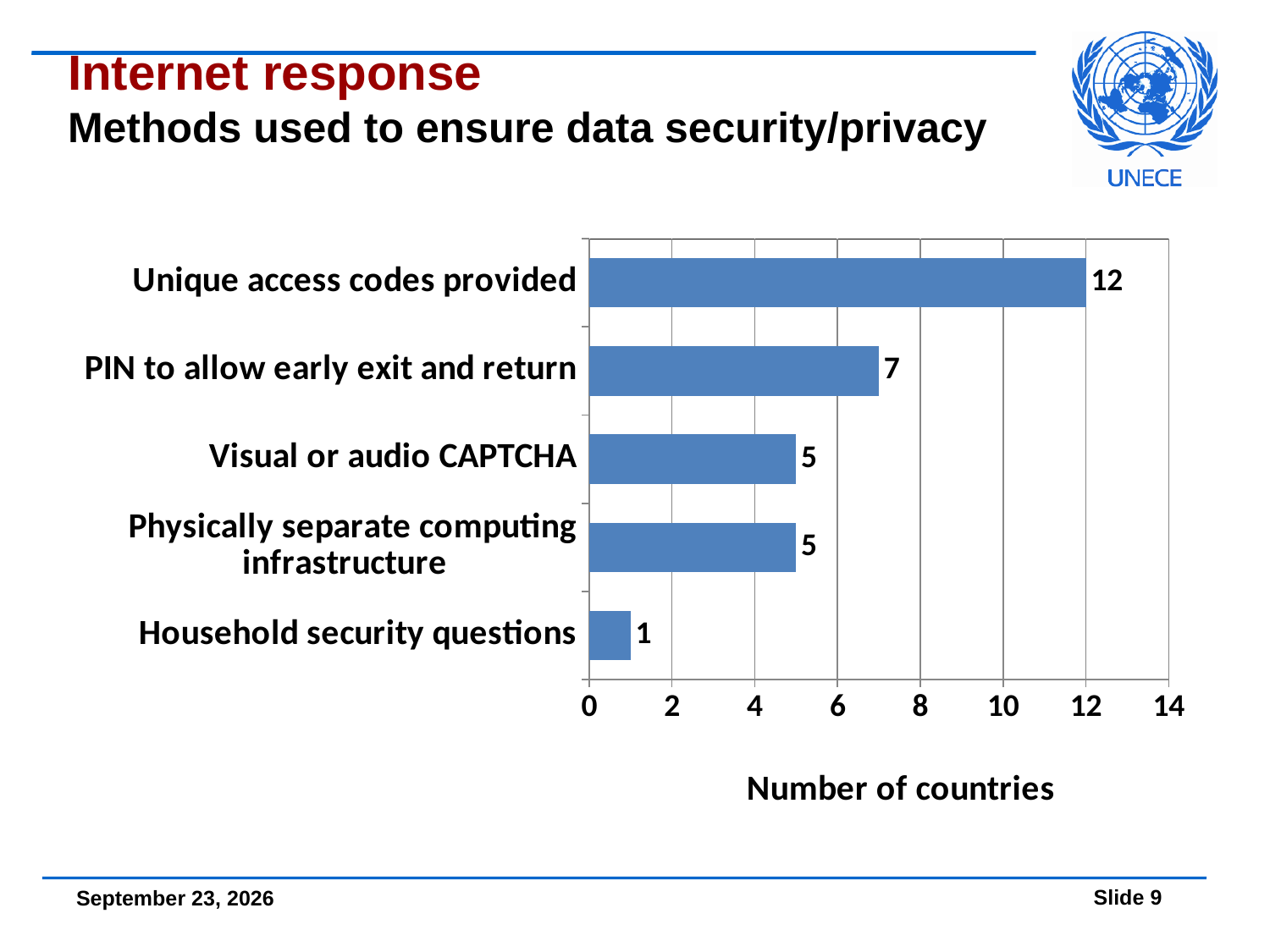
How many methods are shown in the chart? 5 Which was used by more countries: PIN to allow early exit and return or visual or audio CAPTCHA? PIN to allow early exit and return What type of chart is shown on the slide? Bar chart Which method was used by the most countries? Unique access codes provided How many countries used household security questions? 1 How many countries used visual or audio CAPTCHA? 5 What is the maximum value shown on the horizontal axis? 14 What is the difference in the number of countries between unique access codes provided and PIN to allow early exit and return? 5 Which method was used by the fewest countries? Household security questions How many countries used a PIN to allow early exit and return? 7 How many countries provided unique access codes as a data security method? 12 What is the label of the horizontal axis? Number of countries